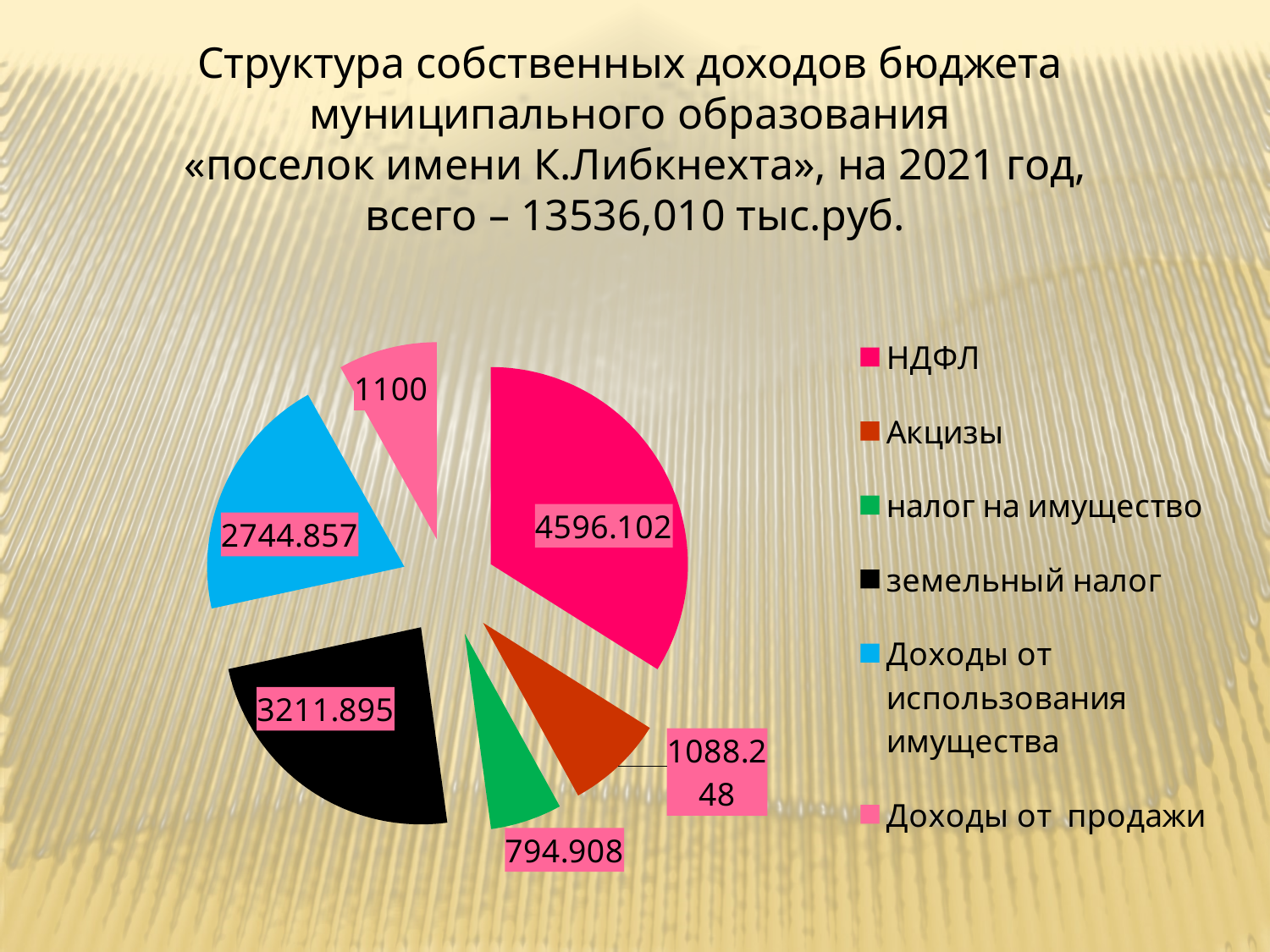
What is the value for НДФЛ? 4596.102 Which is larger, Акцизы or Доходы от продажи? Доходы от продажи How many slices does the pie chart have? 6 What is the difference between НДФЛ and земельный налог? 1384.207 Which category has the smallest slice? налог на имущество What type of chart is shown on the slide? pie chart What is the value for Доходы от продажи? 1100 What is the value for земельный налог? 3211.895 What is the value for Акцизы? 1088.248 What is the value for Доходы от использования имущества? 2744.857 Which category has the largest slice? НДФЛ What colour is the slice for земельный налог? black